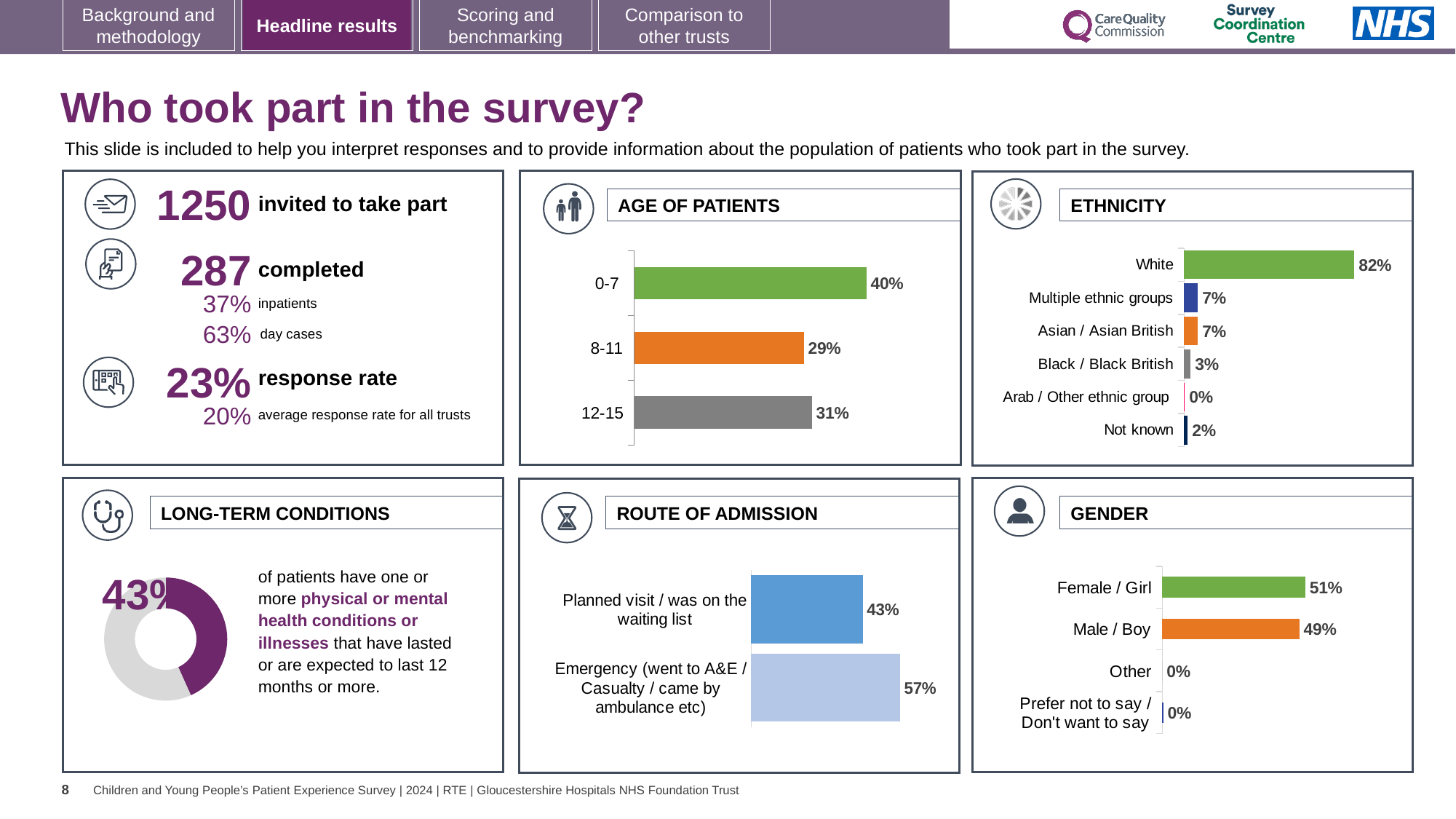
In the ETHNICITY chart, how many ethnicity categories are shown? 6 In the AGE OF PATIENTS chart, which age group has the lowest percentage? 8-11 In the ROUTE OF ADMISSION chart, what is the difference between the Emergency and Planned visit percentages? 14% In the AGE OF PATIENTS chart, what is the difference between the 0-7 and 12-15 percentages? 9% What kind of chart is used in the LONG-TERM CONDITIONS panel? Doughnut chart In the ROUTE OF ADMISSION chart, which route has the larger percentage: Planned visit / was on the waiting list or Emergency? Emergency (went to A&E / Casualty / came by ambulance etc) In the LONG-TERM CONDITIONS chart, what share of patients have one or more long-term conditions? 43% In the ETHNICITY chart, what percentage is shown for Black / Black British? 3% In the AGE OF PATIENTS chart, what percentage of patients were aged 0-7? 40% In the GENDER chart, which category has the highest percentage? Female / Girl In the GENDER chart, what percentage of patients were Male / Boy? 49% In the ETHNICITY chart, what percentage of patients were White? 82%